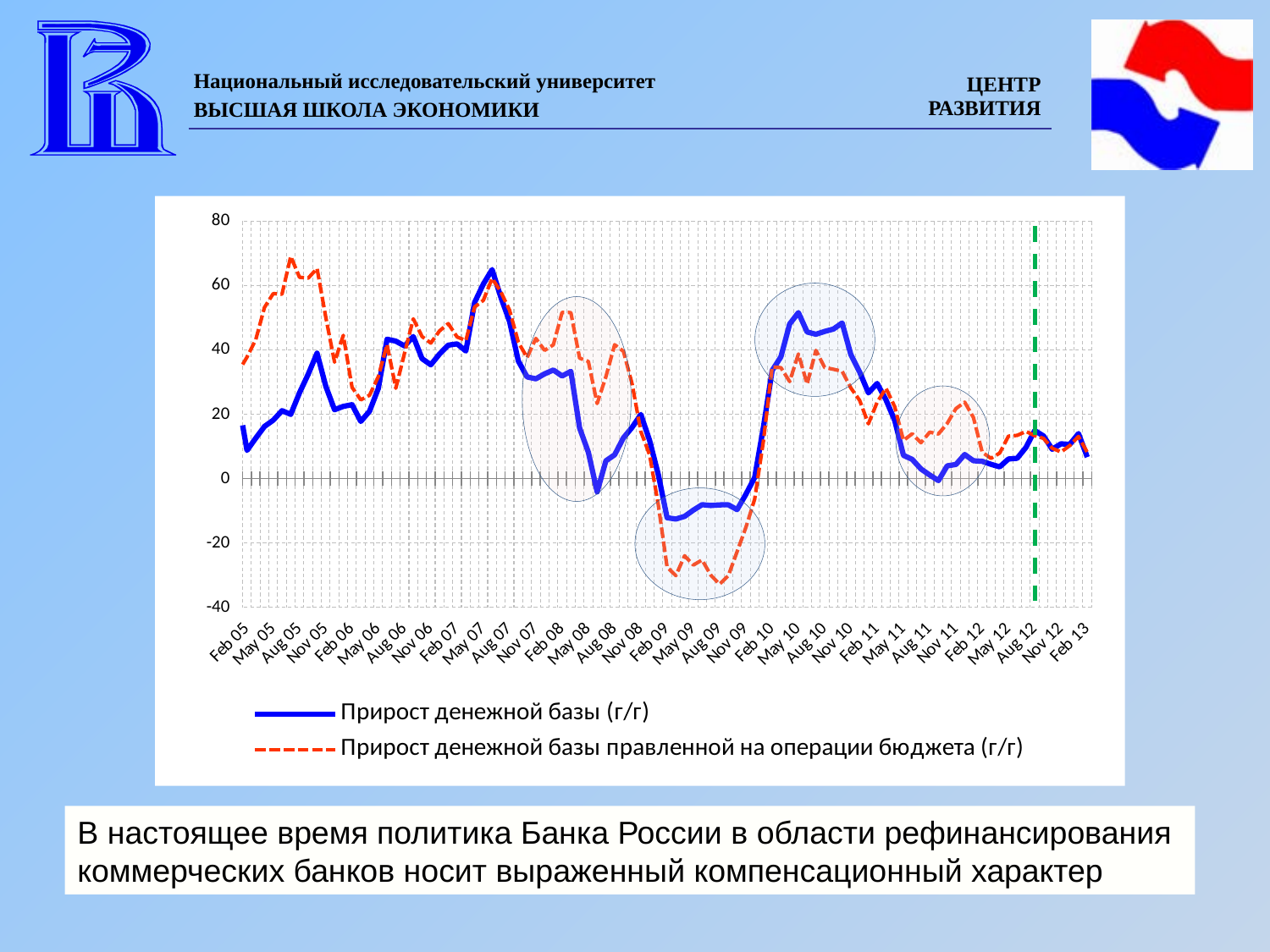
Which series is drawn with a solid blue line? Прирост денежной базы (г/г) At May 10, which series has the higher value: the solid blue series or the dashed red series? the solid blue series Is the value of the dashed red series (Прирост денежной базы правленной на операции бюджета) at May 09 greater or less than -20? less Which series is drawn with a dashed red line? Прирост денежной базы правленной на операции бюджета (г/г) Is the value of the solid blue series (Прирост денежной базы) at May 09 greater or less than 0? less How many series does the legend list? 2 Is the value of the solid blue series (Прирост денежной базы) at May 10 greater or less than 40? greater At Aug 05, which series has the higher value: the solid blue series or the dashed red series? the dashed red series What kind of chart is shown on the slide? line chart Does the solid blue series (Прирост денежной базы) rise or fall between Aug 07 and Feb 09? fall